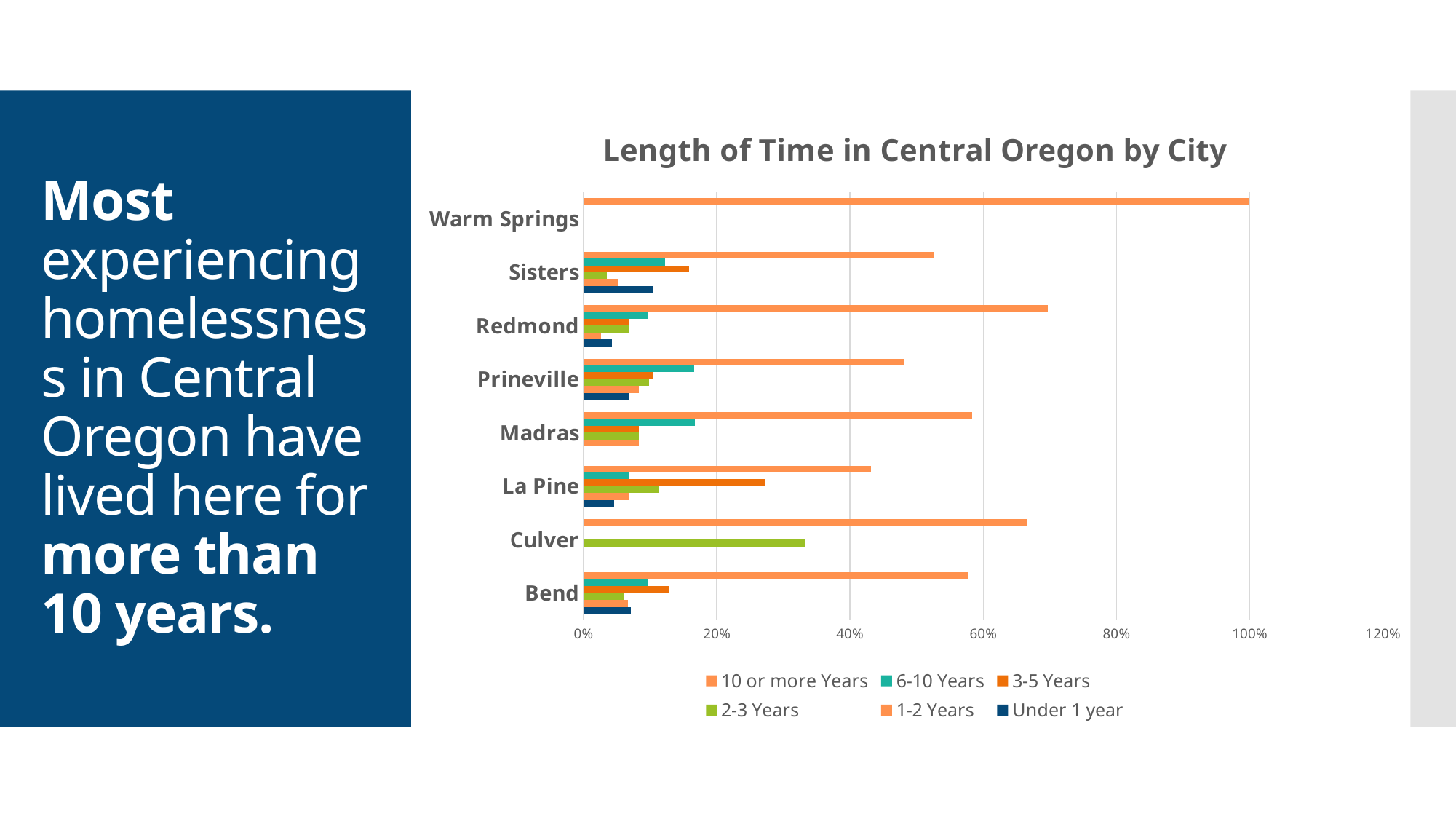
Is the '2-3 Years' value for Culver greater or less than 20%? greater Which city has the larger '10 or more Years' value, Redmond or Prineville? Redmond What is the value of the '10 or more Years' bar for Warm Springs? 100% Is the '3-5 Years' value for La Pine greater or less than 20%? greater Is the '10 or more Years' value for Redmond greater or less than 60%? greater What kind of chart is shown on the slide? Bar chart How many cities are listed on the chart's vertical axis? 8 How many series does the chart's legend list? 6 What is the title of the chart? Length of Time in Central Oregon by City Which city has the highest value for '10 or more Years'? Warm Springs Which city has the larger '10 or more Years' value, Culver or La Pine? Culver